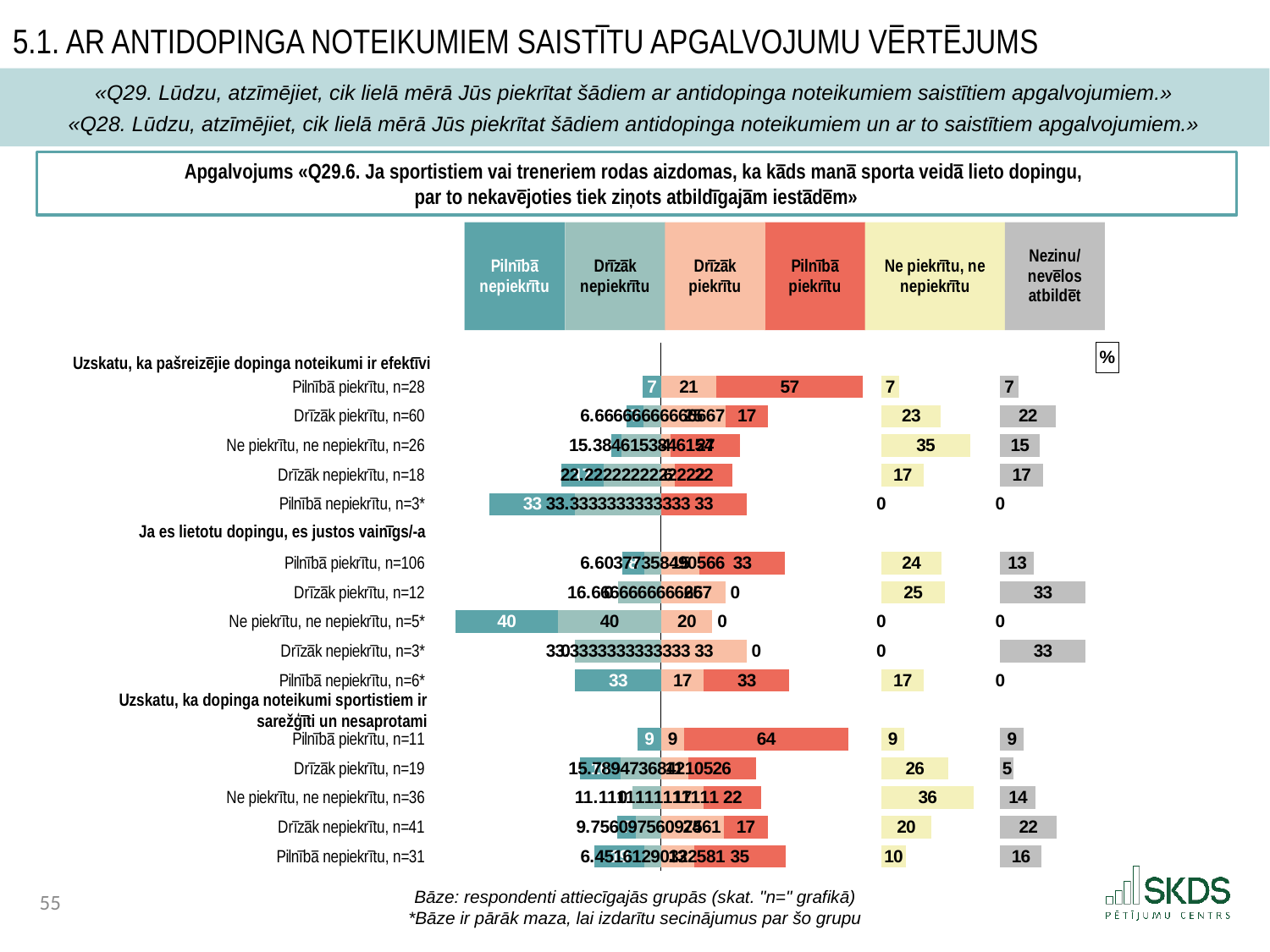
Which row has the highest 'Pilnībā piekrītu' value? Pilnībā piekrītu, n=11 What is the 'Nezinu/nevēlos atbildēt' value for the row 'Drīzāk piekrītu, n=19'? 5 What kind of chart is shown on the slide? Stacked bar chart What is the difference between the 'Pilnībā piekrītu' values for 'Pilnībā piekrītu, n=11' and 'Pilnībā piekrītu, n=28'? 7 Which is larger: the 'Ne piekrītu, ne nepiekrītu' value for 'Ne piekrītu, ne nepiekrītu, n=26' or for 'Drīzāk piekrītu, n=60'? Ne piekrītu, ne nepiekrītu, n=26 What is the 'Pilnībā piekrītu' value for the row 'Pilnībā piekrītu, n=11' under 'Uzskatu, ka dopinga noteikumi sportistiem ir sarežģīti un nesaprotami'? 64 How many series does the legend list? 6 What is the 'Pilnībā piekrītu' value for the row 'Pilnībā piekrītu, n=28' under 'Uzskatu, ka pašreizējie dopinga noteikumi ir efektīvi'? 57 What is the 'Pilnībā nepiekrītu' value for the row 'Ne piekrītu, ne nepiekrītu, n=5*'? 40 What is the 'Pilnībā piekrītu' value for the row 'Pilnībā nepiekrītu, n=31'? 35 What is the 'Nezinu/nevēlos atbildēt' value for the row 'Drīzāk piekrītu, n=12'? 33 What is the 'Ne piekrītu, ne nepiekrītu' value for the row 'Ne piekrītu, ne nepiekrītu, n=36'? 36